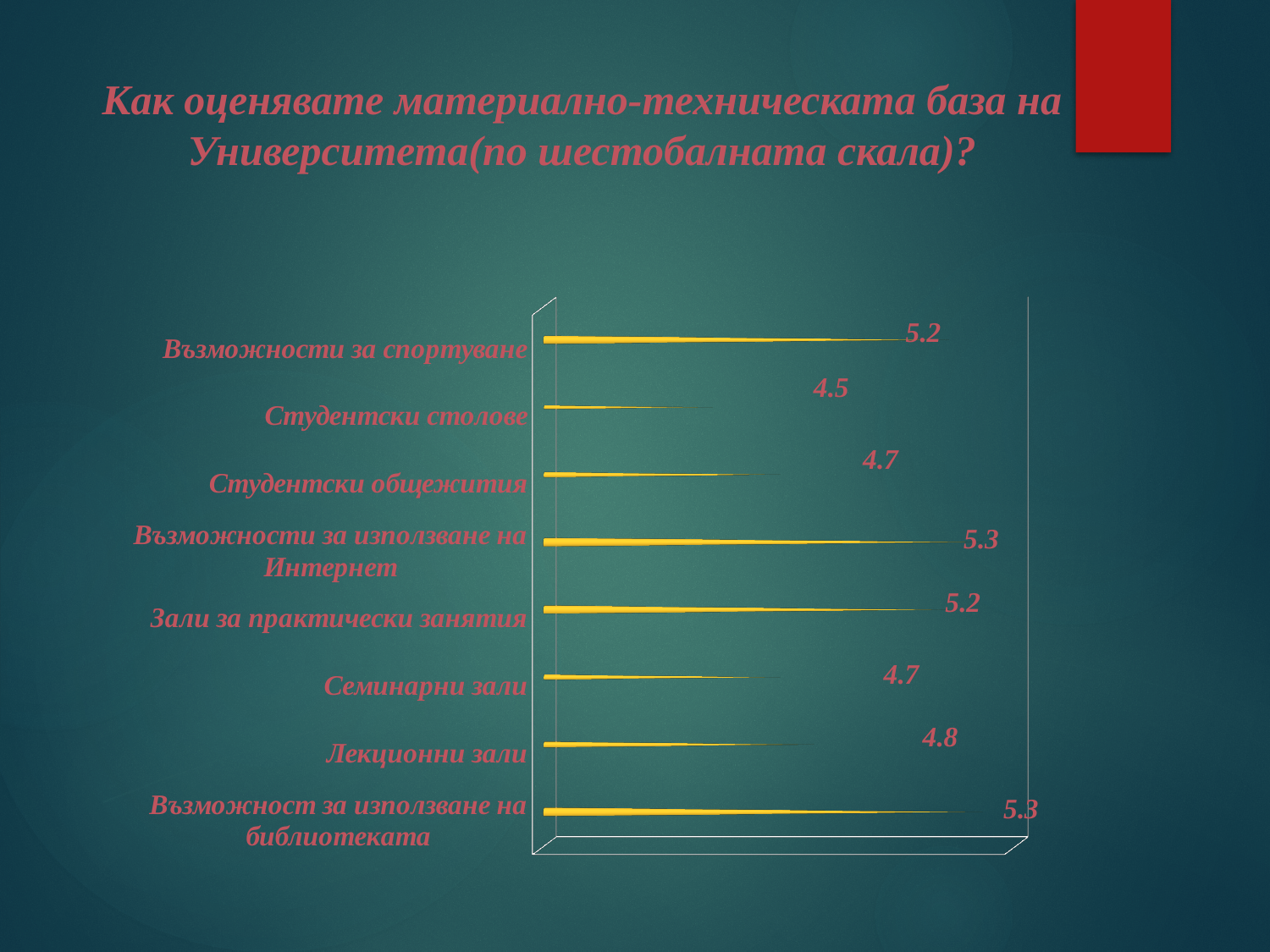
Which is larger, the value for Студентски общежития or the value for Лекционни зали? Лекционни зали What is the value for Лекционни зали? 4.8 How many categories are shown in the chart? 8 What is the difference between the values for Зали за практически занятия and Лекционни зали? 0.4 What is the value for Семинарни зали? 4.7 Which is larger, the value for Възможности за спортуване or the value for Студентски столове? Възможности за спортуване What is the value for Възможности за използване на Интернет? 5.3 What is the value for Студентски столове? 4.5 What is the value for Възможности за спортуване? 5.2 Which category has the lowest value? Студентски столове What kind of chart is shown on the slide? Bar chart What is the difference between the values for Възможност за използване на библиотеката and Студентски столове? 0.8